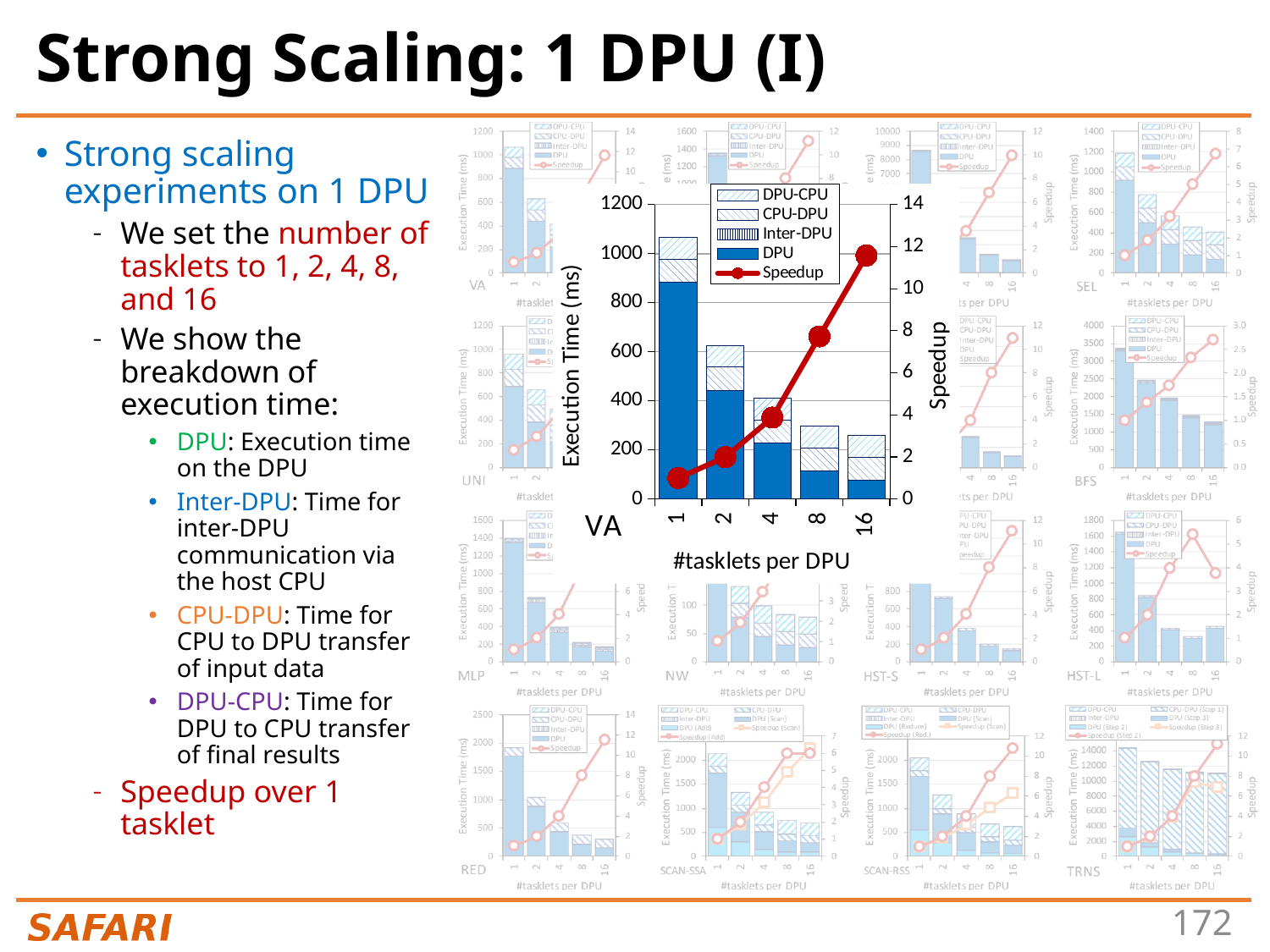
In the enlarged VA chart, is the speedup for 1 tasklet greater or less than 2? less In the enlarged VA chart, does the total execution time rise or fall as the number of tasklets increases? fall In the enlarged VA chart, is the speedup for 16 tasklets greater or less than 10? greater What is the x-axis label of the enlarged VA chart? #tasklets per DPU In the enlarged VA chart, is the total execution time for 16 tasklets greater or less than 400 ms? less In the enlarged VA chart, which has the larger total execution time, 2 tasklets or 4 tasklets? 2 tasklets In the enlarged VA chart, how many series does the legend list? 5 What kind of chart is the enlarged VA chart? combination bar and line chart In the enlarged VA chart, which number of tasklets has the highest speedup? 16 In the enlarged VA chart, how many tasklet counts are shown on the x axis? 5 In the enlarged VA chart, which number of tasklets has the highest total execution time? 1